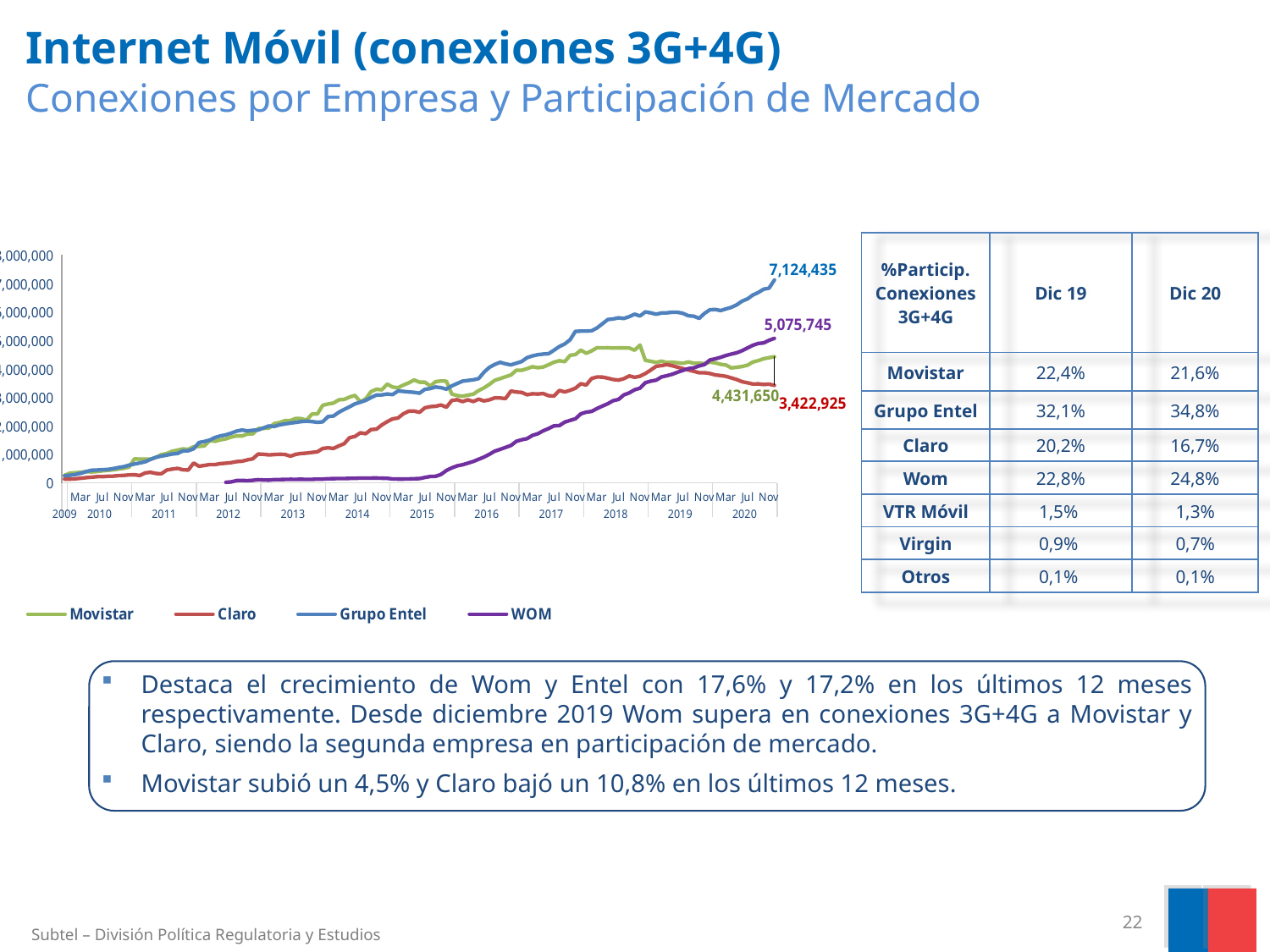
What is the final labelled value for Claro on the chart? 3,422,925 Which series has the highest value at the end of the chart? Grupo Entel At the end of the chart, which is larger: the value for WOM or the value for Movistar? WOM What is the final labelled value for Movistar on the chart? 4,431,650 How many series does the chart legend list? 4 What is the final labelled value for Grupo Entel on the chart? 7,124,435 What is the final labelled value for WOM on the chart? 5,075,745 Does the Grupo Entel line generally rise or fall from 2009 to 2020? rise What kind of chart is shown on the slide? line chart What is the difference between the final labelled values of Grupo Entel and WOM? 2,048,690 What is the difference between the final labelled values of Movistar and Claro? 1,008,725 Which series has the lowest value at the end of the chart? Claro